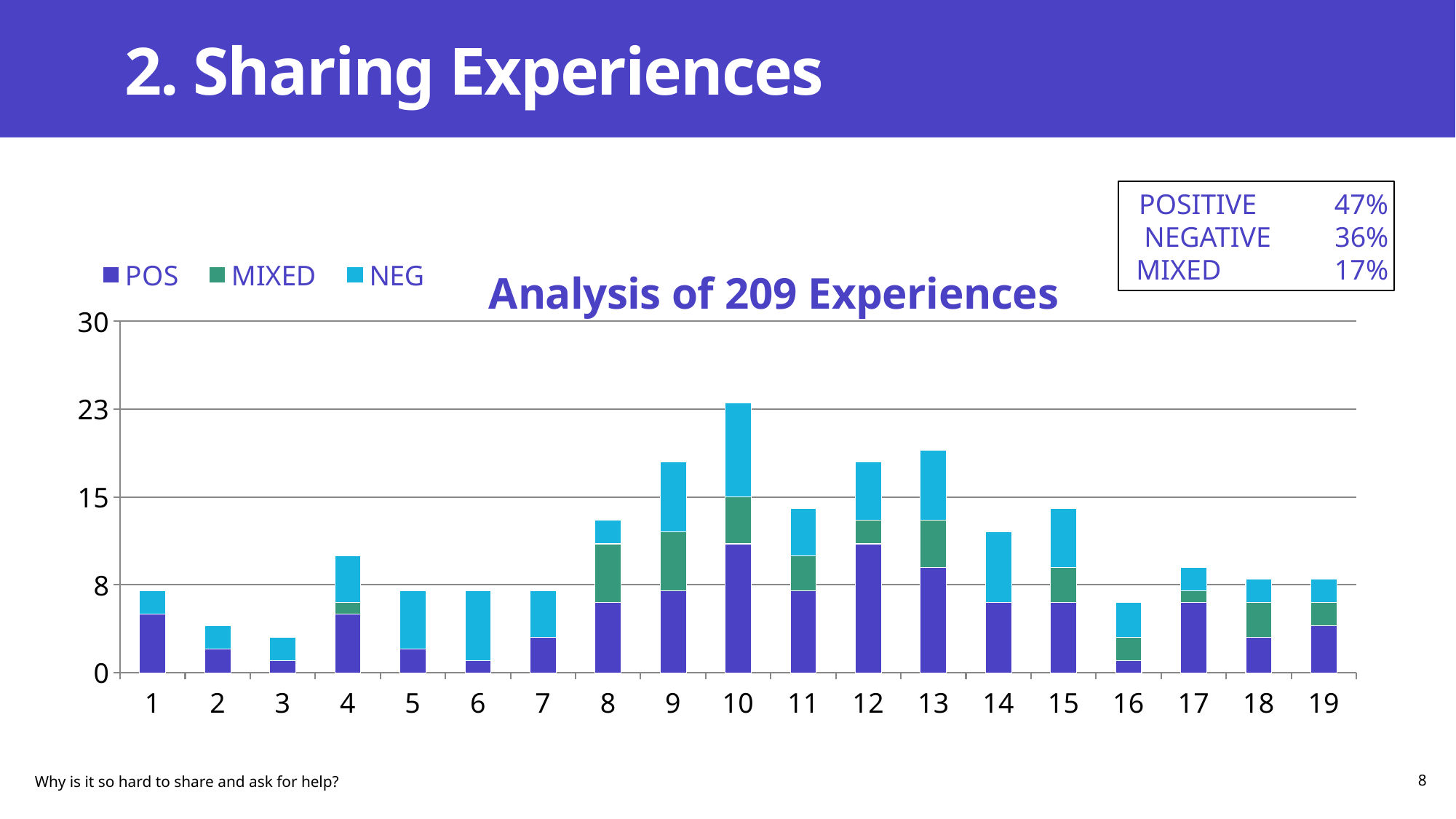
Is the total bar for category 9 greater or less than 15? greater What are the series names listed in the chart legend? POS, MIXED, NEG Which has the larger total bar, category 4 or category 5? 4 How many categories are shown along the x axis of the chart? 19 Which category has the lowest total bar in the chart? 3 Is the total bar for category 14 greater or less than 15? less Which has the larger total bar, category 10 or category 9? 10 What kind of chart is shown on the slide? Stacked bar chart How many series does the chart legend list? 3 What is the title of the chart? Analysis of 209 Experiences Which category has the highest total bar in the chart? 10 Is the total bar for category 16 greater or less than 8? less